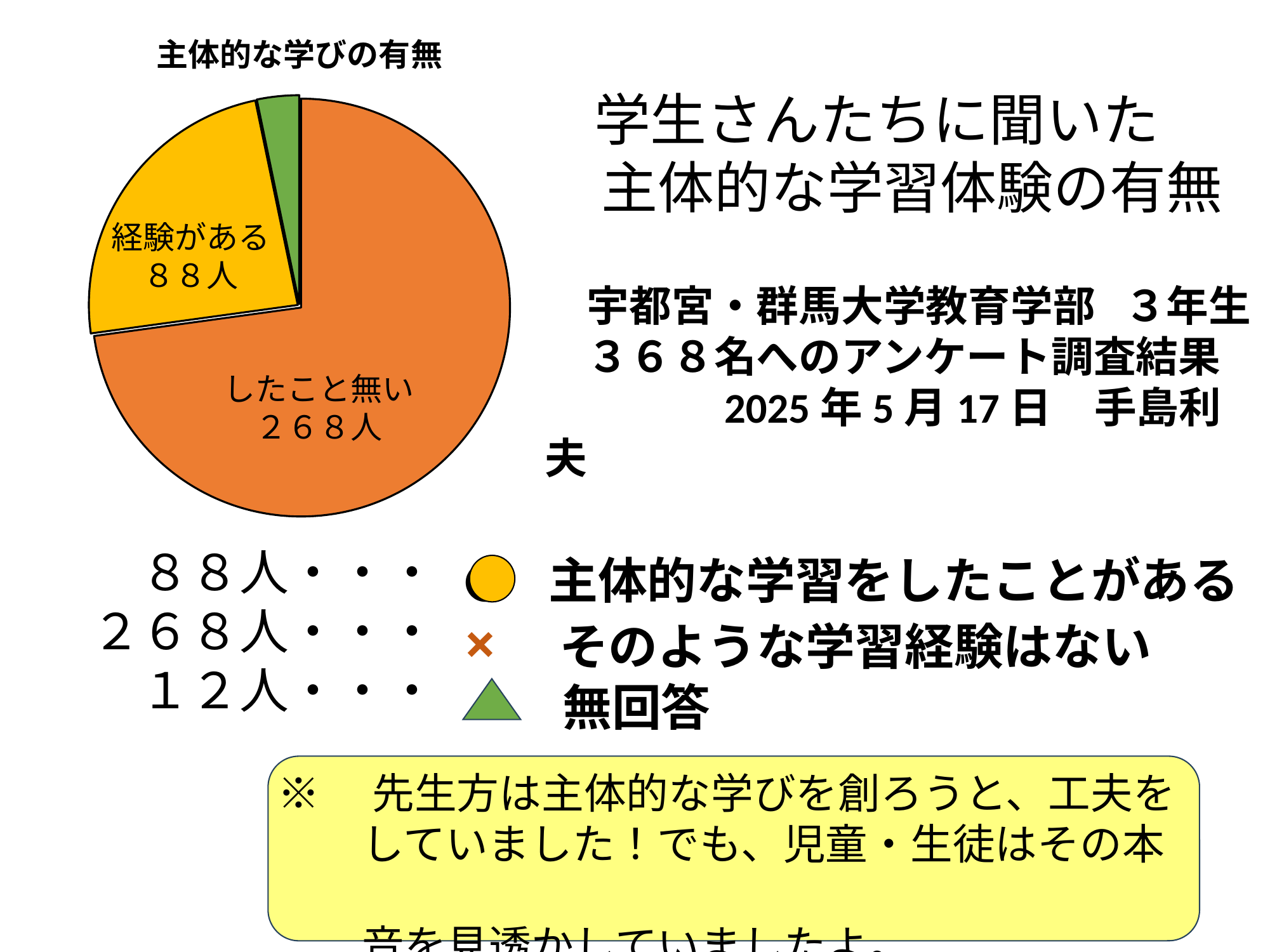
How many people are in the 経験がある slice of the pie chart? 88人 What is the title of the pie chart? 主体的な学びの有無 Which slice of the pie chart is the largest? したこと無い Which slice of the pie chart is the smallest? 無回答 (the green slice) According to the slide, how many people does the green slice (無回答) represent? 12人 How many people are in the したこと無い slice of the pie chart? 268人 Which is larger in the pie chart, 経験がある or したこと無い? したこと無い What type of chart is shown on the slide? Pie chart What is the difference between the したこと無い and 経験がある values in the pie chart? 180人 How many slices does the pie chart have? 3 What colour is the 経験がある slice in the pie chart? Yellow